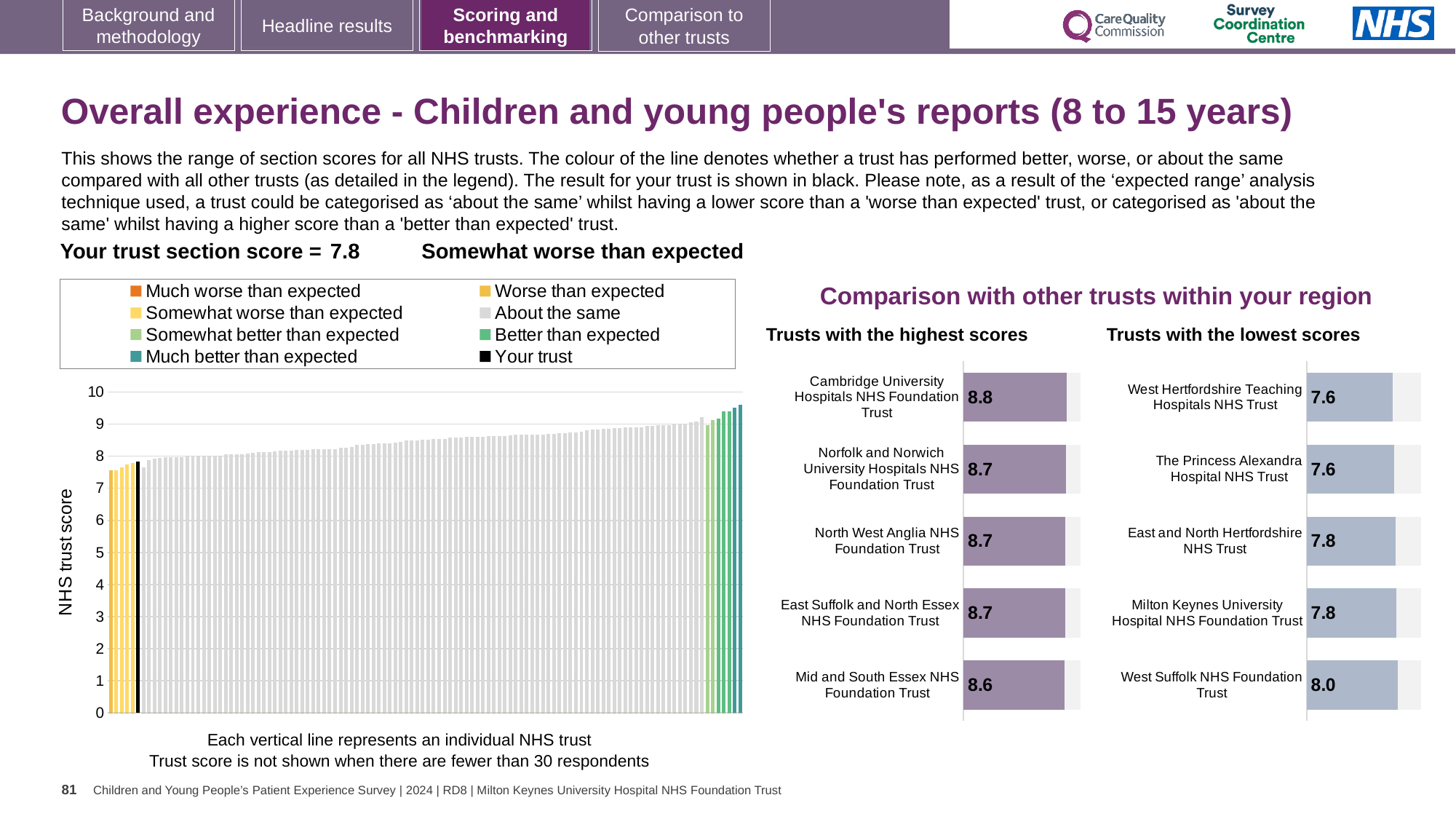
In the 'Trusts with the lowest scores' chart, which has the larger score: West Suffolk NHS Foundation Trust or West Hertfordshire Teaching Hospitals NHS Trust? West Suffolk NHS Foundation Trust In the 'Trusts with the highest scores' chart, what is the difference between the scores of Cambridge University Hospitals NHS Foundation Trust and Mid and South Essex NHS Foundation Trust? 0.2 In the 'Trusts with the lowest scores' chart, which trust has the highest score? West Suffolk NHS Foundation Trust How many entries does the legend above the large chart on the left list? 8 In the 'Trusts with the highest scores' chart, how many trusts are shown? 5 In the 'Trusts with the highest scores' chart, what is the score for Cambridge University Hospitals NHS Foundation Trust? 8.8 In the large chart on the left, do the trust scores rise or fall from left to right? rise In the large chart on the left, is the value for your trust (the black bar) greater or less than 8? less In the 'Trusts with the highest scores' chart, which trust has the highest score? Cambridge University Hospitals NHS Foundation Trust In the large chart on the left, what is the section score for your trust (the black bar)? 7.8 What kind of chart is the large chart on the left of the slide? bar chart In the 'Trusts with the lowest scores' chart, what is the score for Milton Keynes University Hospital NHS Foundation Trust? 7.8